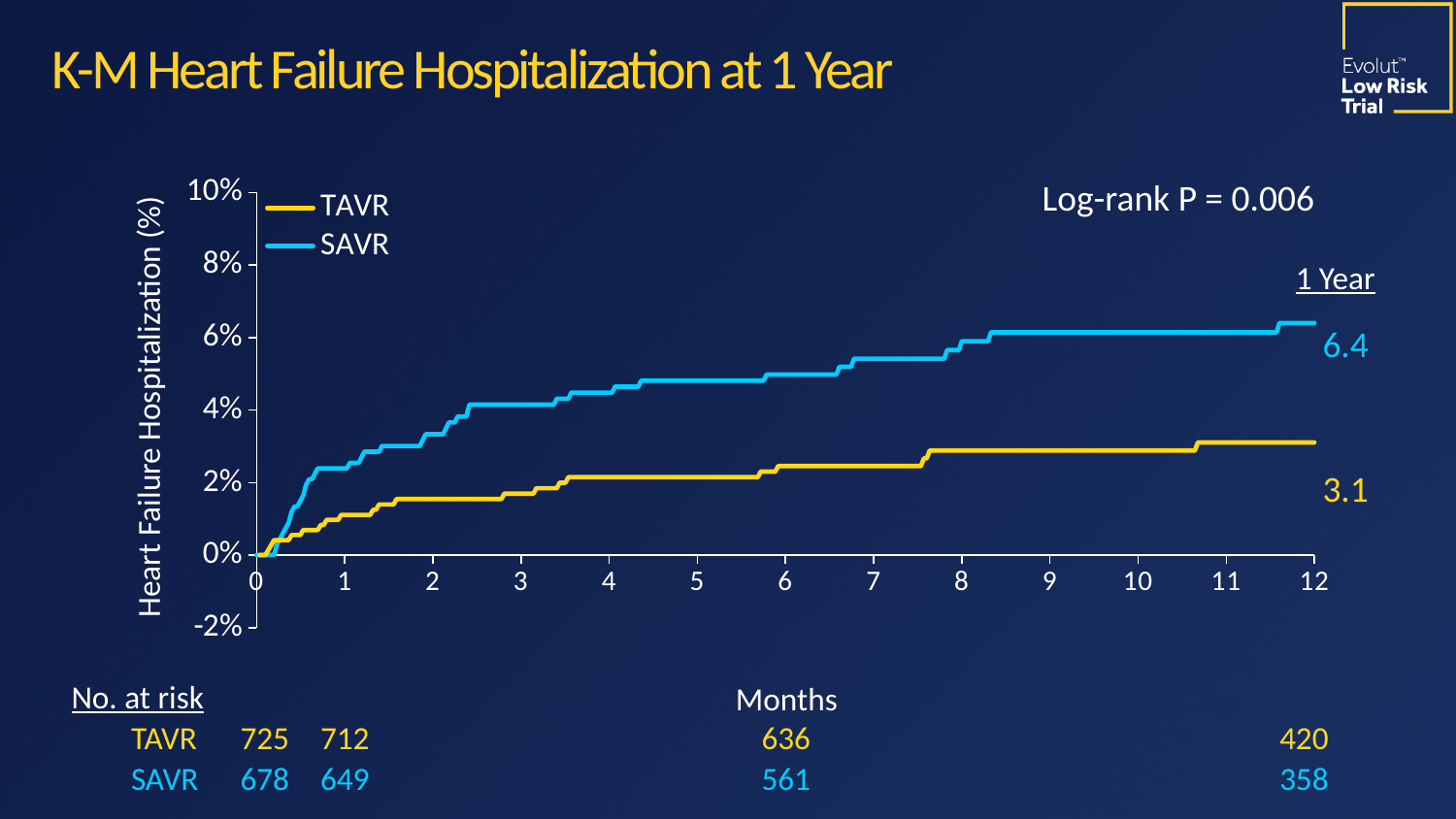
Is the SAVR heart failure hospitalization rate at month 6 greater or less than 4%? greater What is the log-rank P value shown on the chart? 0.006 What kind of chart is shown on the slide? Line chart (Kaplan-Meier curve) What is the heart failure hospitalization rate for SAVR at 1 year? 6.4 Is the TAVR heart failure hospitalization rate at month 6 greater or less than 4%? less What is the heart failure hospitalization rate for TAVR at 1 year? 3.1 How many TAVR patients are at risk at month 0 according to the number-at-risk table? 725 Which colour represents the SAVR curve? Blue Do the heart failure hospitalization curves rise or fall as months increase? Rise What is the difference between the SAVR and TAVR heart failure hospitalization rates at 1 year? 3.3 Which group has the higher heart failure hospitalization rate at 1 year, TAVR or SAVR? SAVR How many series does the legend list? 2